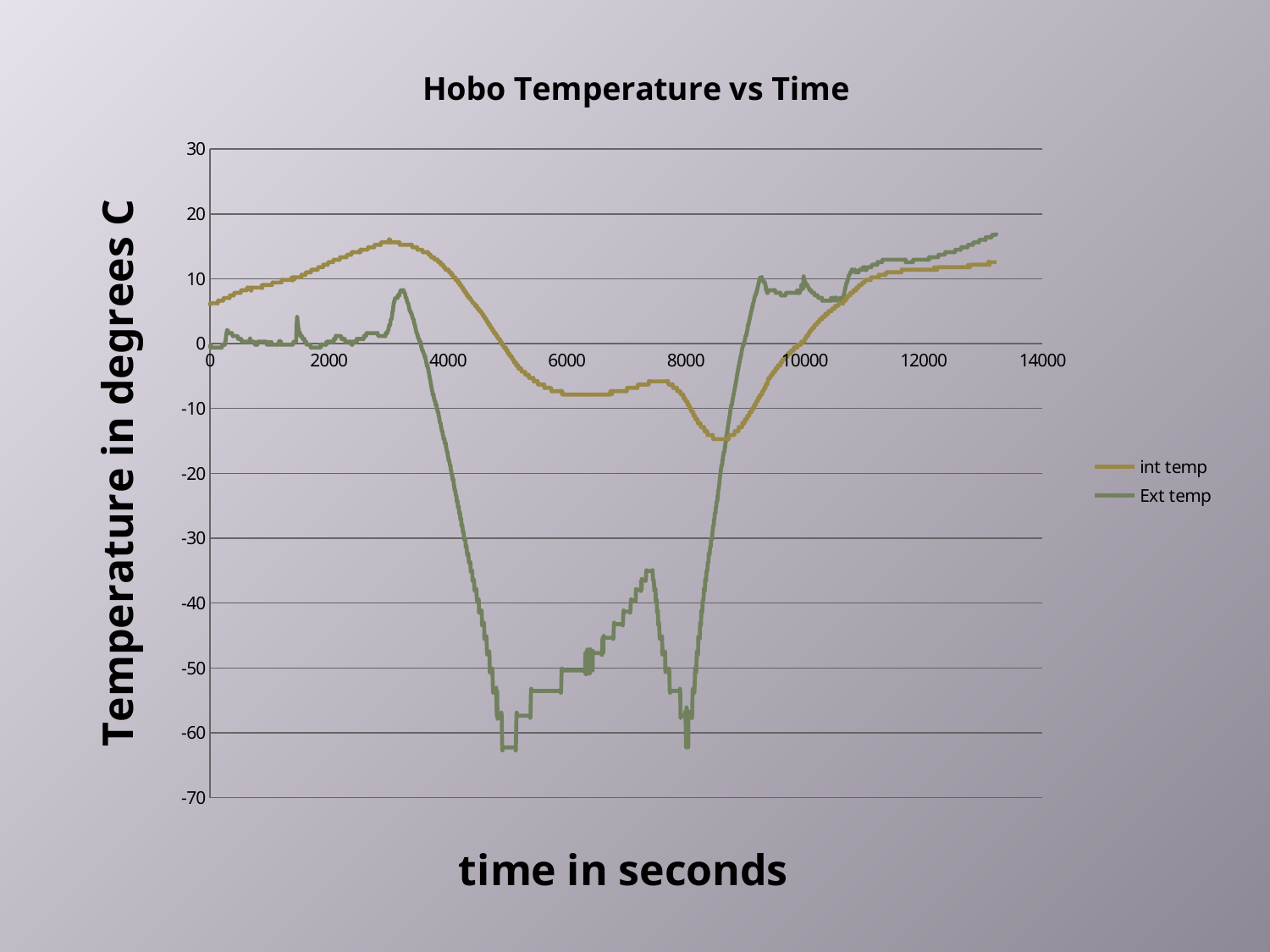
What is the title of the chart? Hobo Temperature vs Time Is the value of Ext temp at 6000 seconds greater or less than -40? less How many series does the legend list? 2 Does the Ext temp series rise or fall between 4000 and 5000 seconds? fall What is the label on the x axis of the chart? time in seconds At 13000 seconds, which series has the higher value, int temp or Ext temp? Ext temp Is the value of int temp at 2000 seconds greater or less than 5? greater At 6000 seconds, which series has the higher value, int temp or Ext temp? int temp Is the value of int temp at 6000 seconds greater or less than 0? less What kind of chart is shown on the slide? line chart Which series reaches the lowest temperature on the chart? Ext temp